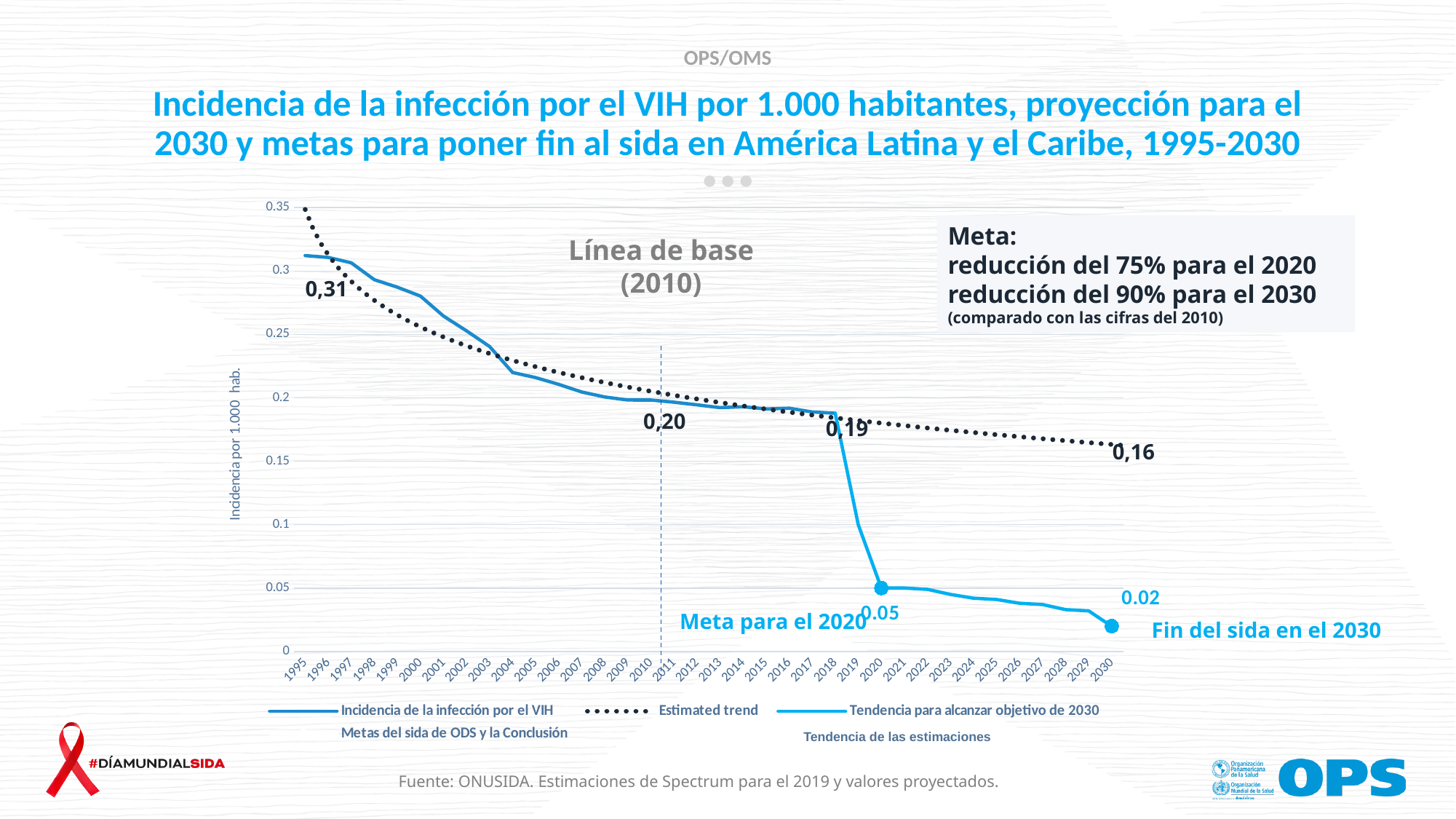
What is the baseline (2010) HIV incidence value labelled on the chart? 0,20 In 2030, which is larger: the estimated trend value or the target trend value? Estimated trend What is the value labelled for the end of AIDS in 2030 (Fin del sida en el 2030)? 0.02 What is the HIV incidence value labelled for 1995? 0,31 What is the HIV incidence value labelled for 2018? 0,19 What type of chart is shown on the slide? Line chart What value does the estimated trend (dotted line) reach in 2030? 0,16 Does the HIV incidence line rise or fall from 1995 to 2018? Fall How many series does the chart legend list? 3 Is the HIV incidence value for 2004 greater or less than 0.25? less What is the value labelled for the 2020 target (Meta para el 2020)? 0.05 What is the difference between the 1995 value (0,31) and the 2010 baseline value (0,20)? 0,11